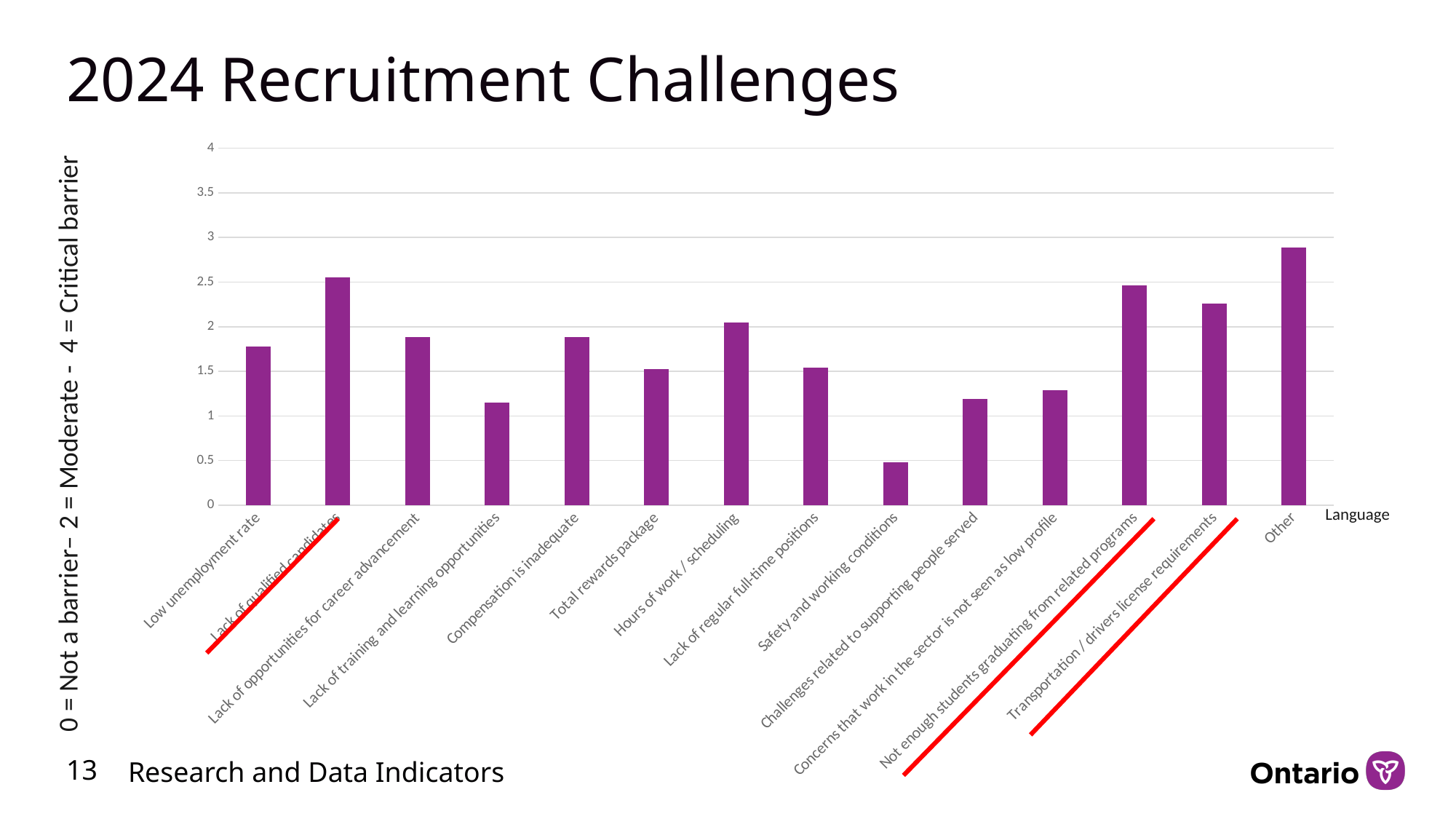
Is the value for Safety and working conditions greater or less than 1? less Which is larger: Hours of work / scheduling or Total rewards package? Hours of work / scheduling What kind of chart is shown on the slide? Bar chart Is the value for Transportation / drivers license requirements greater or less than 2? greater Which recruitment challenge has the highest bar? Other Which is larger: Lack of qualified candidates or Transportation / drivers license requirements? Lack of qualified candidates Is the value for Other greater or less than 2.5? greater What colour are the bars in the chart? Purple Which recruitment challenge has the lowest bar? Safety and working conditions